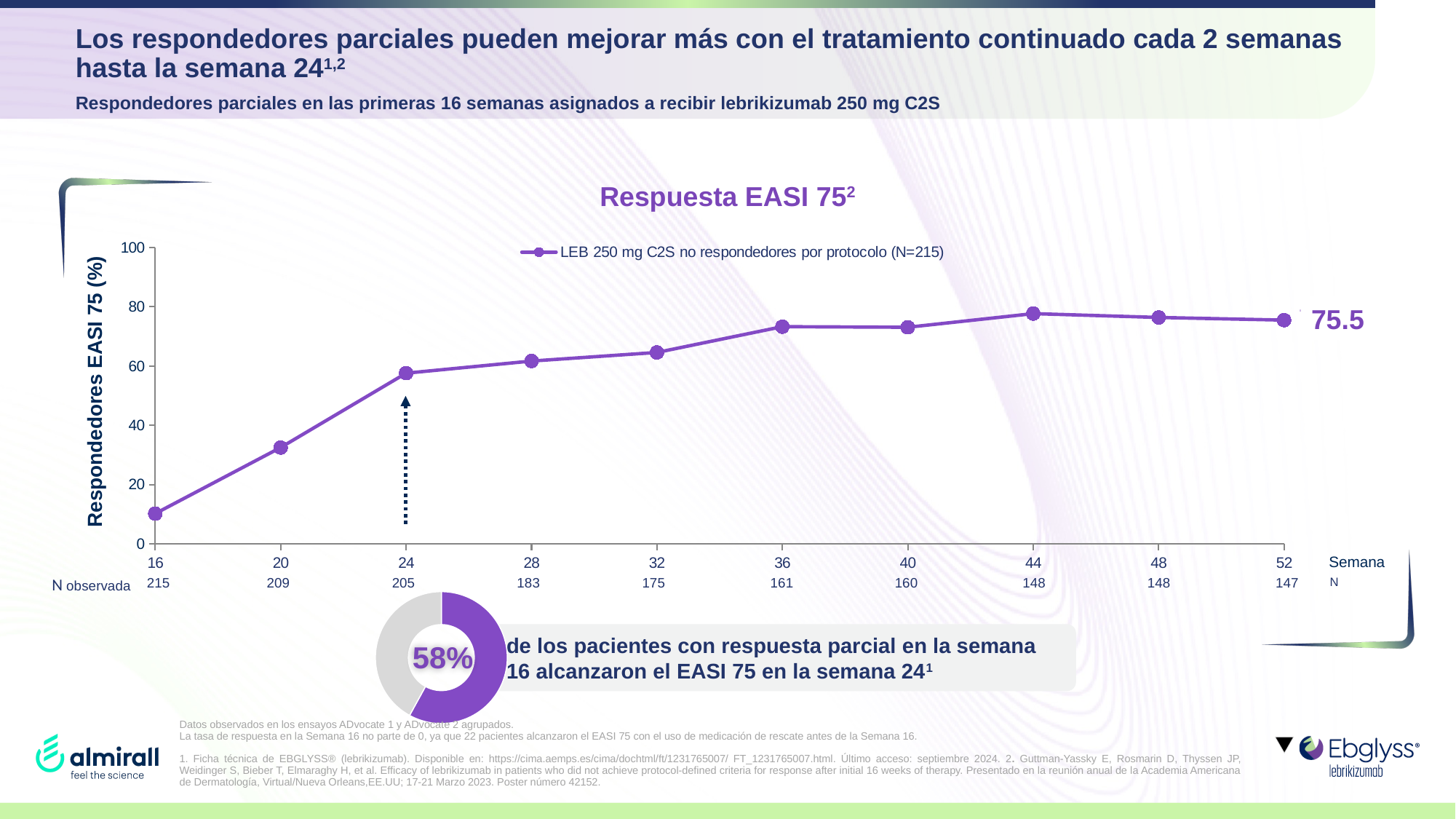
In the 'Respuesta EASI 75' chart, is the value at week 36 greater or less than 60? greater In the 'Respuesta EASI 75' chart, which is larger, the value at week 20 or the value at week 24? week 24 In the donut chart at the bottom of the slide, what percentage of patients with partial response at week 16 reached EASI 75 at week 24? 58% In the 'Respuesta EASI 75' chart, do the values generally rise or fall from week 16 to week 52? rise In the 'Respuesta EASI 75' chart, what is the N observada at week 52? 147 How many series does the legend of the 'Respuesta EASI 75' chart list? 1 How many data points are plotted on the 'Respuesta EASI 75' line? 10 What is the legend entry of the 'Respuesta EASI 75' chart? LEB 250 mg C2S no respondedores por protocolo (N=215) In the 'Respuesta EASI 75' chart, what is the EASI 75 response value labelled at week 52? 75.5 In the 'Respuesta EASI 75' chart, is the value at week 16 greater or less than 20? less In the 'Respuesta EASI 75' chart, which week has the lowest EASI 75 response? 16 What kind of chart is the 'Respuesta EASI 75' chart? line chart